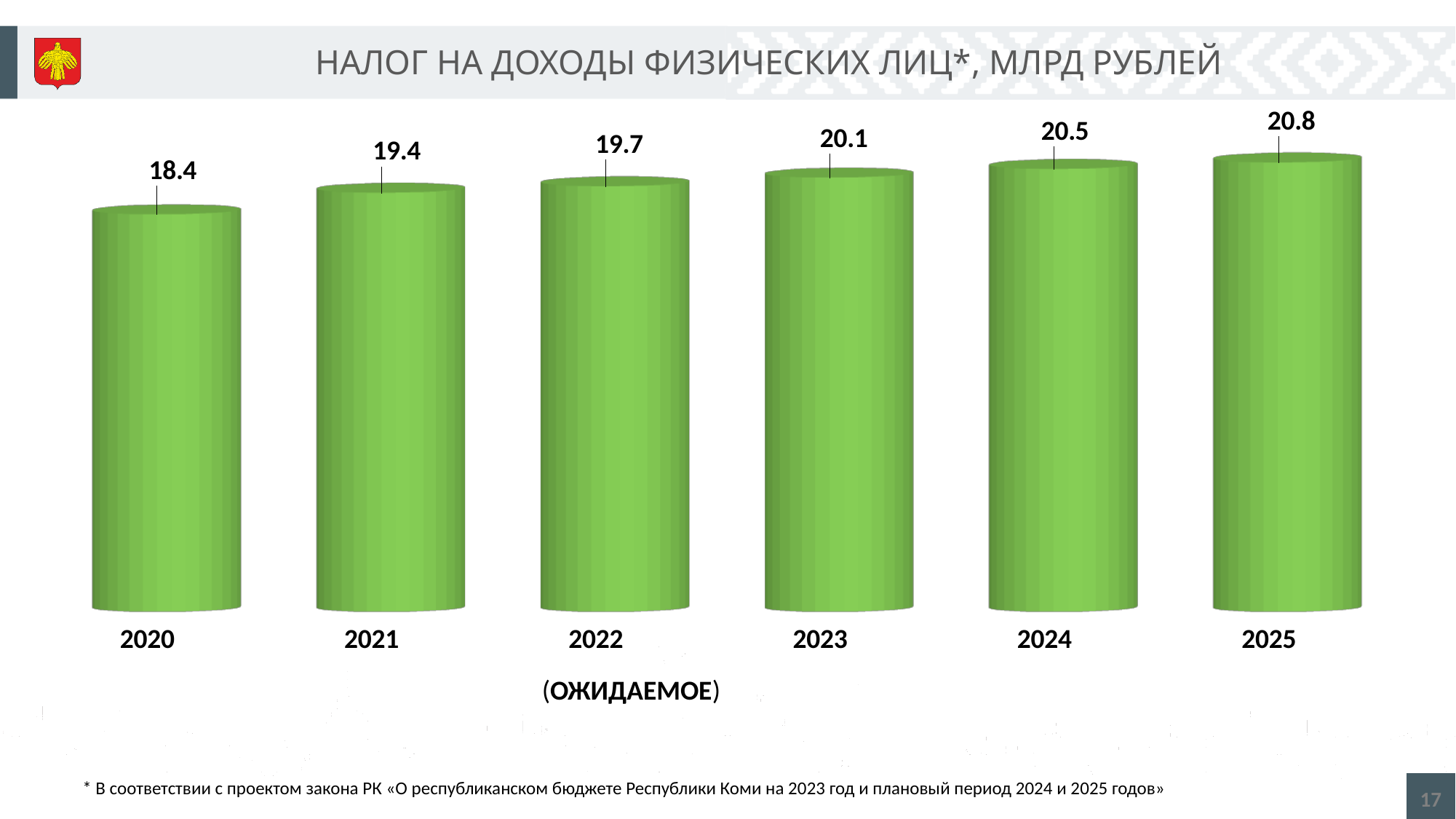
Which year has the highest value? 2025 Which is larger, the value for 2021 or the value for 2024? 2024 What is the difference between the values for 2025 and 2020? 2.4 Do the values rise or fall from 2020 to 2025? rise Which year has the lowest value? 2020 How many years are shown on the chart? 6 What is the value for 2022? 19.7 What is the title of the chart? НАЛОГ НА ДОХОДЫ ФИЗИЧЕСКИХ ЛИЦ*, МЛРД РУБЛЕЙ What is the difference between the values for 2023 and 2021? 0.7 What is the value for 2020? 18.4 What is the value for 2025? 20.8 What kind of chart is this? bar chart